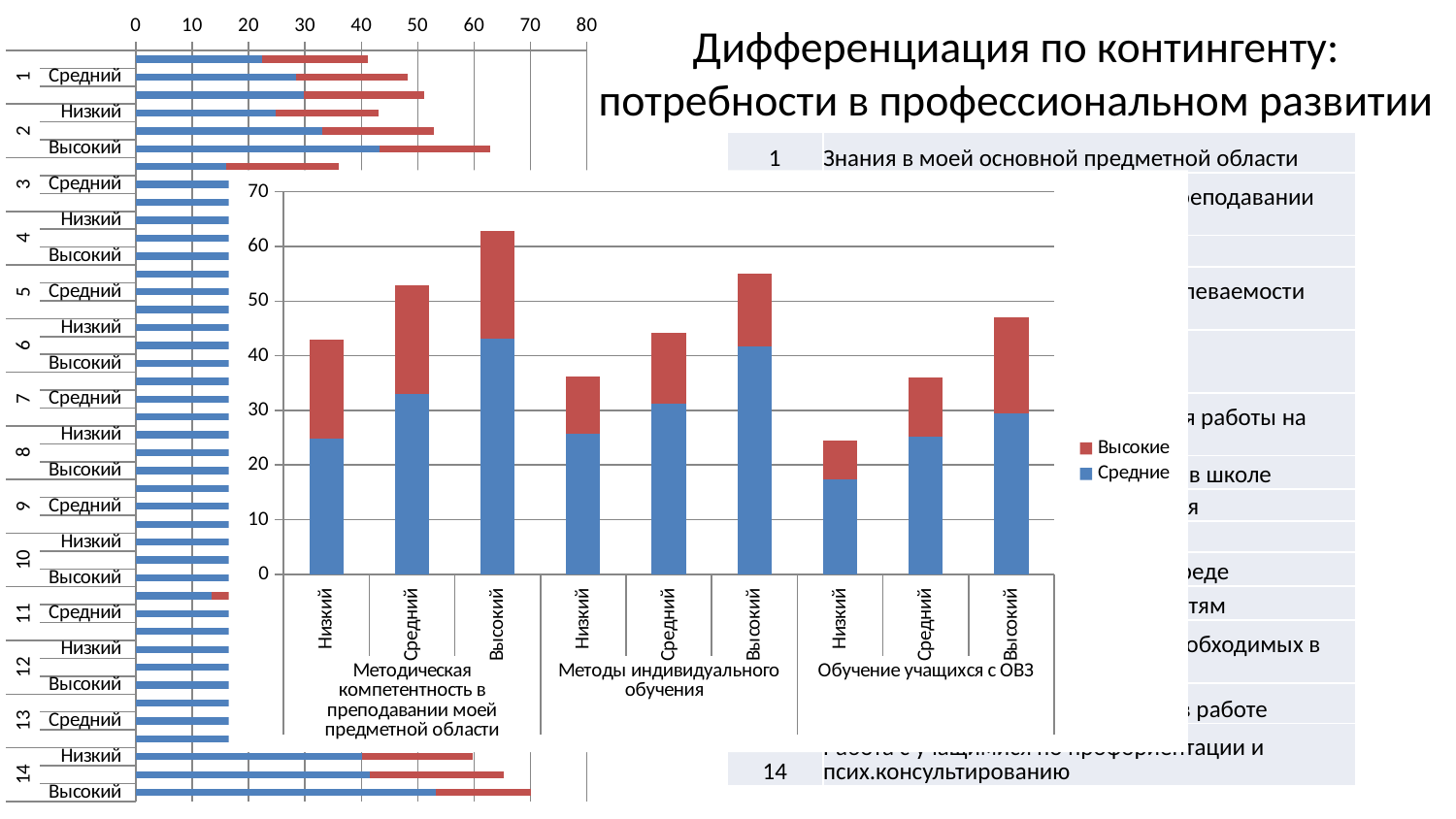
In the central stacked bar chart, how many bars are plotted in total? 9 In the central stacked bar chart, which is larger: the total for 'Средний' under 'Методы индивидуального обучения' or the total for 'Средний' under 'Обучение учащихся с ОВЗ'? Средний under Методы индивидуального обучения What kind of chart is the central chart with groups 'Методическая компетентность', 'Методы индивидуального обучения' and 'Обучение учащихся с ОВЗ'? Stacked bar chart In the central stacked bar chart, within each group do the bar totals rise or fall going from 'Низкий' to 'Высокий'? rise In the central stacked bar chart, is the total for 'Высокий' under 'Методическая компетентность в преподавании моей предметной области' greater or less than 60? greater What kind of chart is the large chart on the left side of the slide with categories numbered 1 to 14? Bar chart In the central stacked bar chart, how many series does the legend list? 2 In the central stacked bar chart, is the total for 'Низкий' under 'Обучение учащихся с ОВЗ' greater or less than 30? less In the central stacked bar chart, which bar has the lowest total? Низкий in Обучение учащихся с ОВЗ In the central stacked bar chart, which series is shown in blue? Средние In the central stacked bar chart, which bar has the highest total? Высокий in Методическая компетентность в преподавании моей предметной области In the central stacked bar chart, is the 'Средние' portion for 'Высокий' under 'Методы индивидуального обучения' greater or less than 40? greater